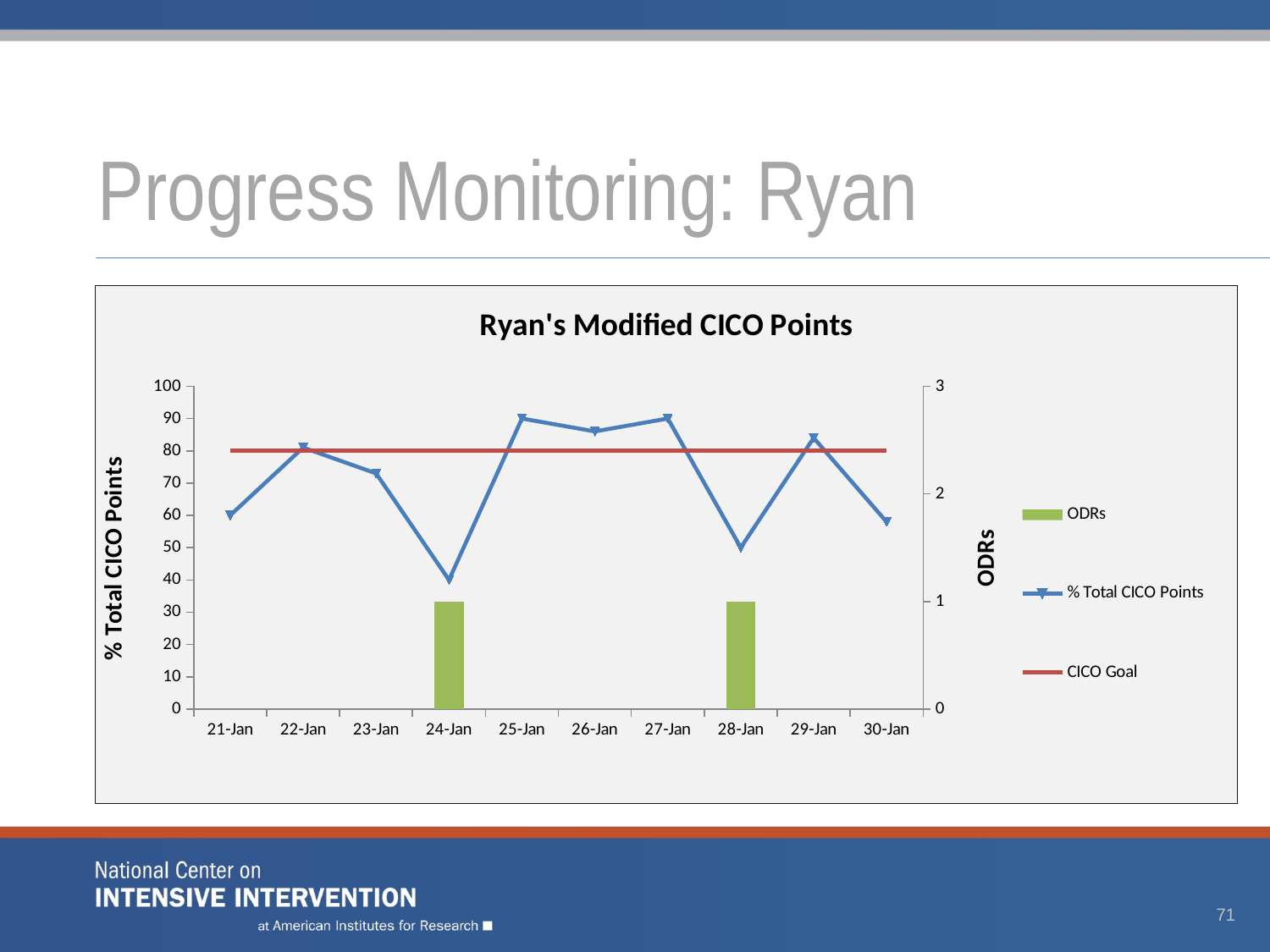
What value does the CICO Goal line sit at on the % Total CICO Points axis? 80 What kind of chart is shown on the slide? A combined bar and line chart Which date has the lowest % Total CICO Points value? 24-Jan Is the % Total CICO Points value for 25-Jan greater or less than 80? greater Which date has the higher % Total CICO Points value, 22-Jan or 23-Jan? 22-Jan What is the ODRs value on 24-Jan? 1 Is the % Total CICO Points value for 28-Jan greater or less than 60? less How many series does the legend list? 3 What is the title of the chart? Ryan's Modified CICO Points How many dates are shown on the x axis? 10 Is the % Total CICO Points value for 21-Jan greater or less than 70? less On how many dates is an ODRs bar shown? 2